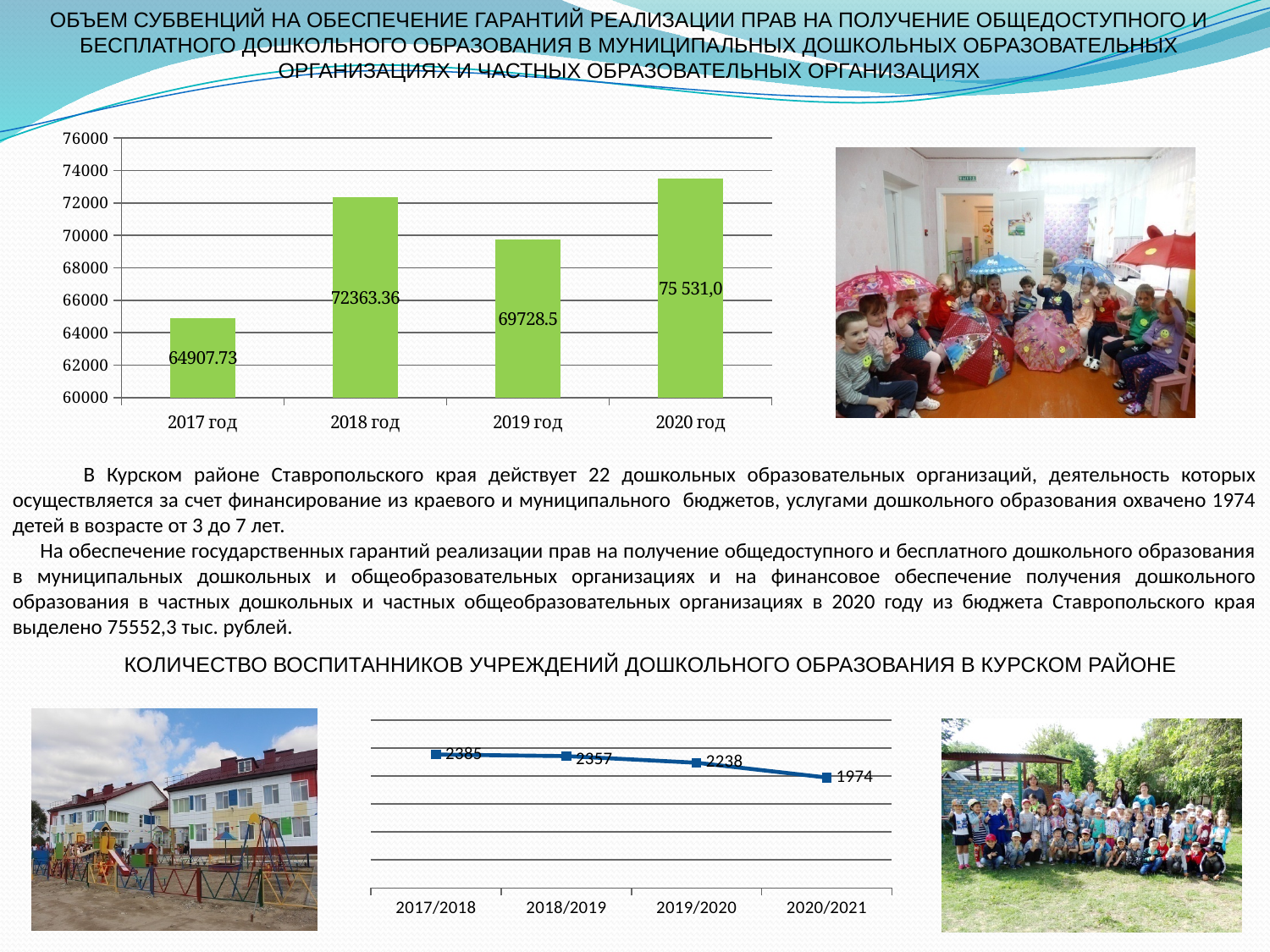
In the top bar chart, what is the value for 2017 год? 64907.73 In the bottom line chart (Количество воспитанников), do the values rise or fall from 2017/2018 to 2020/2021? fall What type of chart is the top chart on the slide? bar chart In the top bar chart, which year has the lowest value? 2017 год In the top bar chart, which year has the highest value? 2020 год In the top bar chart, what is the value for 2020 год? 75 531,0 In the bottom line chart (Количество воспитанников), what is the value for 2020/2021? 1974 In the top bar chart, what is the value for 2018 год? 72363.36 In the top bar chart, which is larger: the value for 2018 год or 2019 год? 2018 год In the top bar chart, what is the difference between the values for 2018 год and 2017 год? 7455.63 In the bottom line chart (Количество воспитанников), what is the difference between the values for 2017/2018 and 2020/2021? 411 How many bars are in the top bar chart? 4